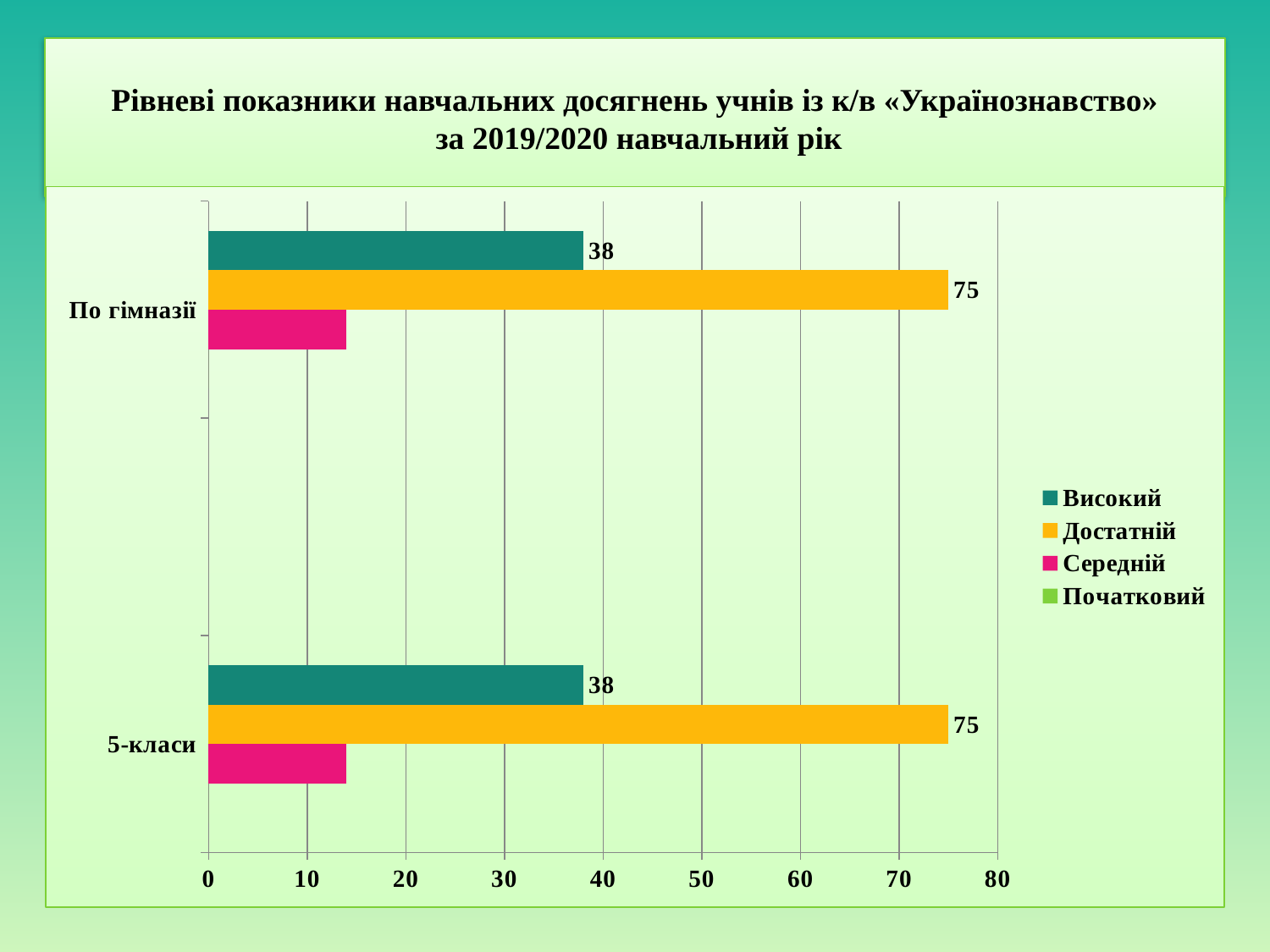
Is the value of the Середній series for По гімназії greater or less than 10? greater What is the value of the Достатній series for По гімназії? 75 What is the value of the Високий series for По гімназії? 38 Which legend entry is shown in yellow? Достатній Is the value of the Середній series for 5-класи greater or less than 20? less What is the difference between the Достатній and Високий values for По гімназії? 37 Which series has the highest value for 5-класи? Достатній What is the value of the Високий series for 5-класи? 38 How many series does the legend list? 4 For 5-класи, which is larger: the Достатній value or the Високий value? Достатній What kind of chart is shown on the slide? bar chart How many categories are shown on the vertical axis? 2